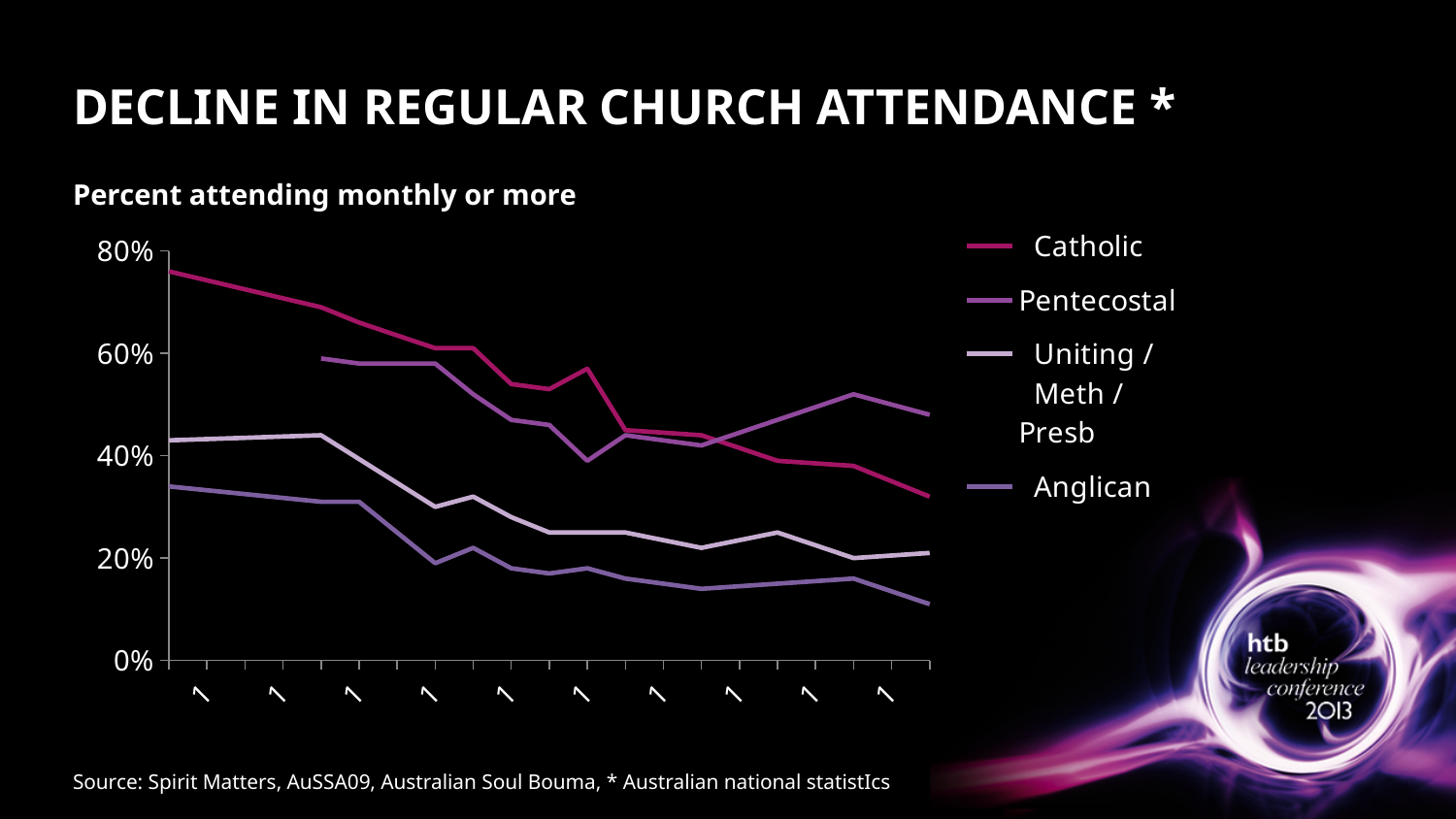
Does the Catholic line rise or fall from left to right across the chart? fall Is the Catholic value at the right end of the chart greater or less than 40%? less Is the Catholic value at the left end of the chart greater or less than 60%? greater Does the Pentecostal line end higher or lower than where it starts? lower What does the chart's subtitle say is being measured? Percent attending monthly or more Does the Anglican line rise or fall from left to right across the chart? fall How many series does the legend list? 4 What kind of chart is shown on the slide? line chart Which series has the highest value at the left end of the chart? Catholic Is the Anglican value at the right end of the chart greater or less than 20%? less At the right end of the chart, which is larger: the Pentecostal value or the Catholic value? Pentecostal Which series has the lowest value at the right end of the chart? Anglican